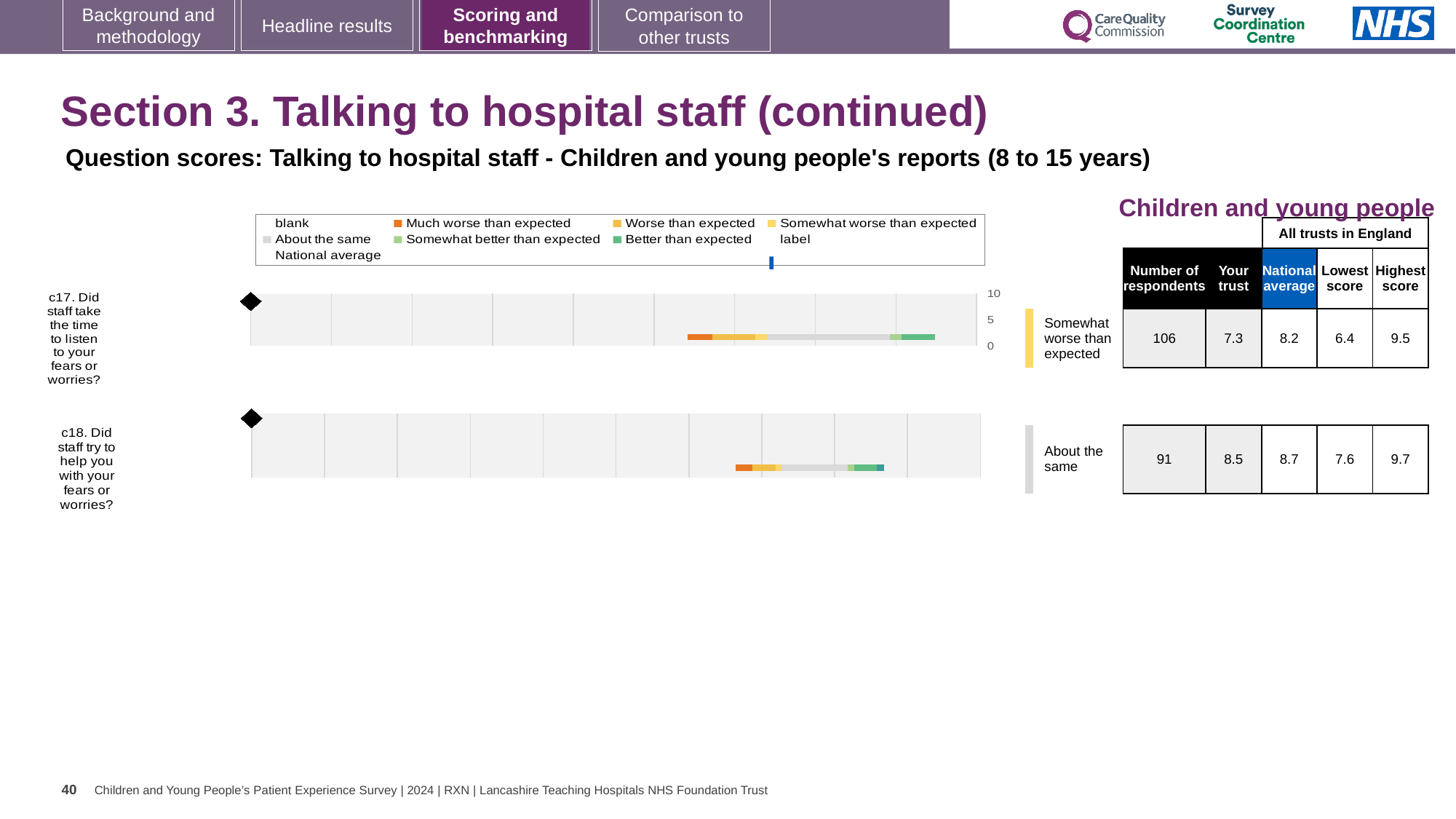
What is the national average score for c18 (Did staff try to help you with your fears or worries?)? 8.7 For c17, which is larger: the 'Your trust' score or the national average? National average What is the difference between the highest score and the lowest score for c18? 2.1 Which question has the higher 'Your trust' score, c17 or c18? c18 What is the 'Your trust' score for c17 (Did staff take the time to listen to your fears or worries?)? 7.3 What benchmark category is shown for c18? About the same What is the lowest score across all trusts in England for c17? 6.4 What is the difference between the national average and the 'Your trust' score for c17? 0.9 How many survey questions are plotted on the slide? 2 What benchmark category is shown for c17? Somewhat worse than expected How many respondents answered question c17? 106 What kind of chart is used to show the question scores for c17 and c18? bar chart